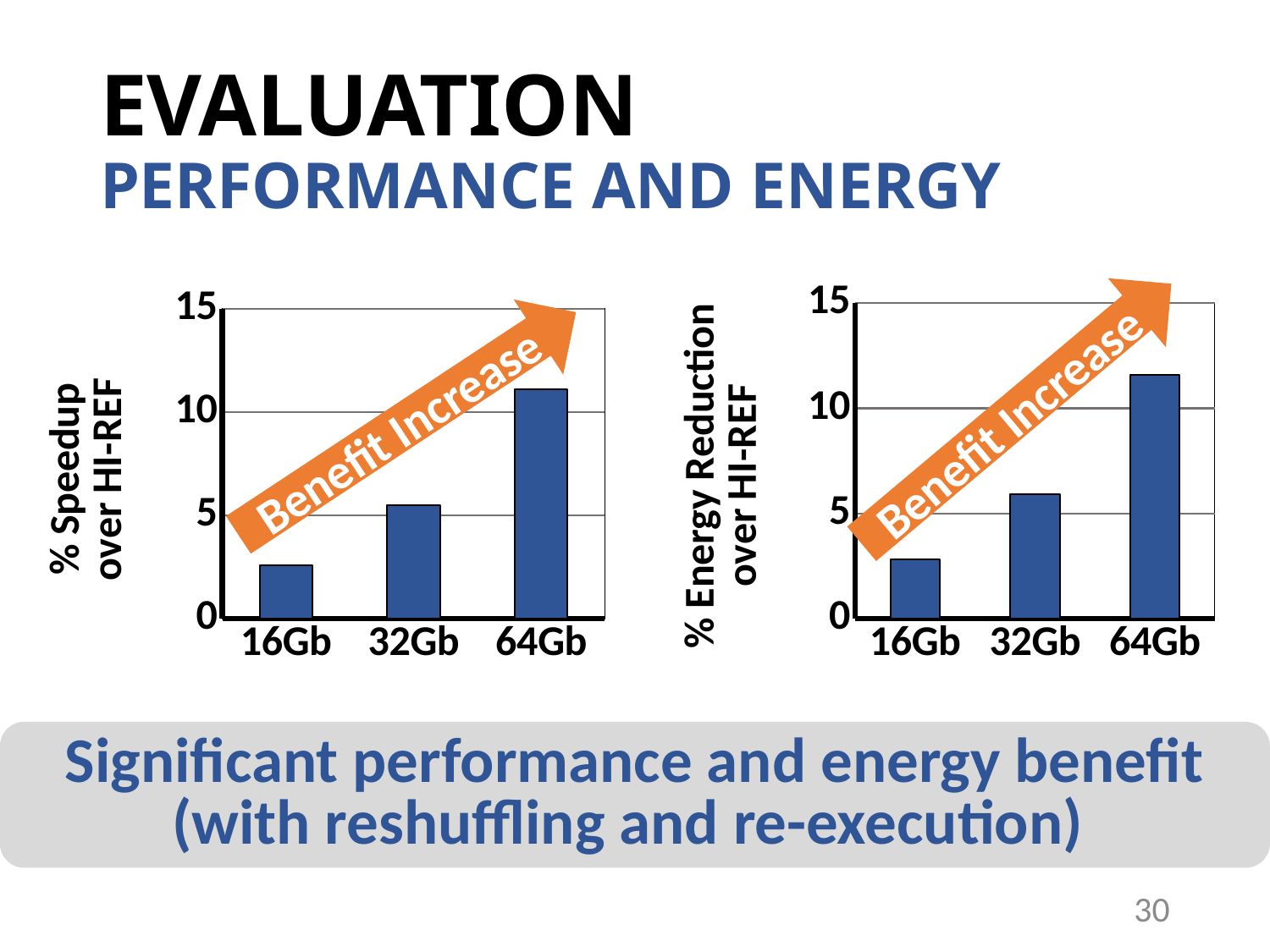
How many DRAM capacities are shown on the x axis of the right chart (% Energy Reduction over HI-REF)? 3 On the right chart (% Energy Reduction over HI-REF), which DRAM capacity has the highest energy reduction? 64Gb On the right chart (% Energy Reduction over HI-REF), is the value for 32Gb greater or less than 5? greater What kind of chart is the left chart (% Speedup over HI-REF)? Bar chart On the left chart (% Speedup over HI-REF), which DRAM capacity has the highest speedup? 64Gb On the right chart (% Energy Reduction over HI-REF), do the values rise or fall as capacity increases from 16Gb to 64Gb? Rise On the right chart (% Energy Reduction over HI-REF), is the value for 16Gb greater or less than 5? less On the left chart (% Speedup over HI-REF), which is larger, the value for 32Gb or the value for 64Gb? 64Gb On the left chart (% Speedup over HI-REF), is the value for 16Gb greater or less than 5? less On the right chart (% Energy Reduction over HI-REF), which DRAM capacity has the lowest energy reduction? 16Gb On the left chart (% Speedup over HI-REF), which DRAM capacity has the lowest speedup? 16Gb